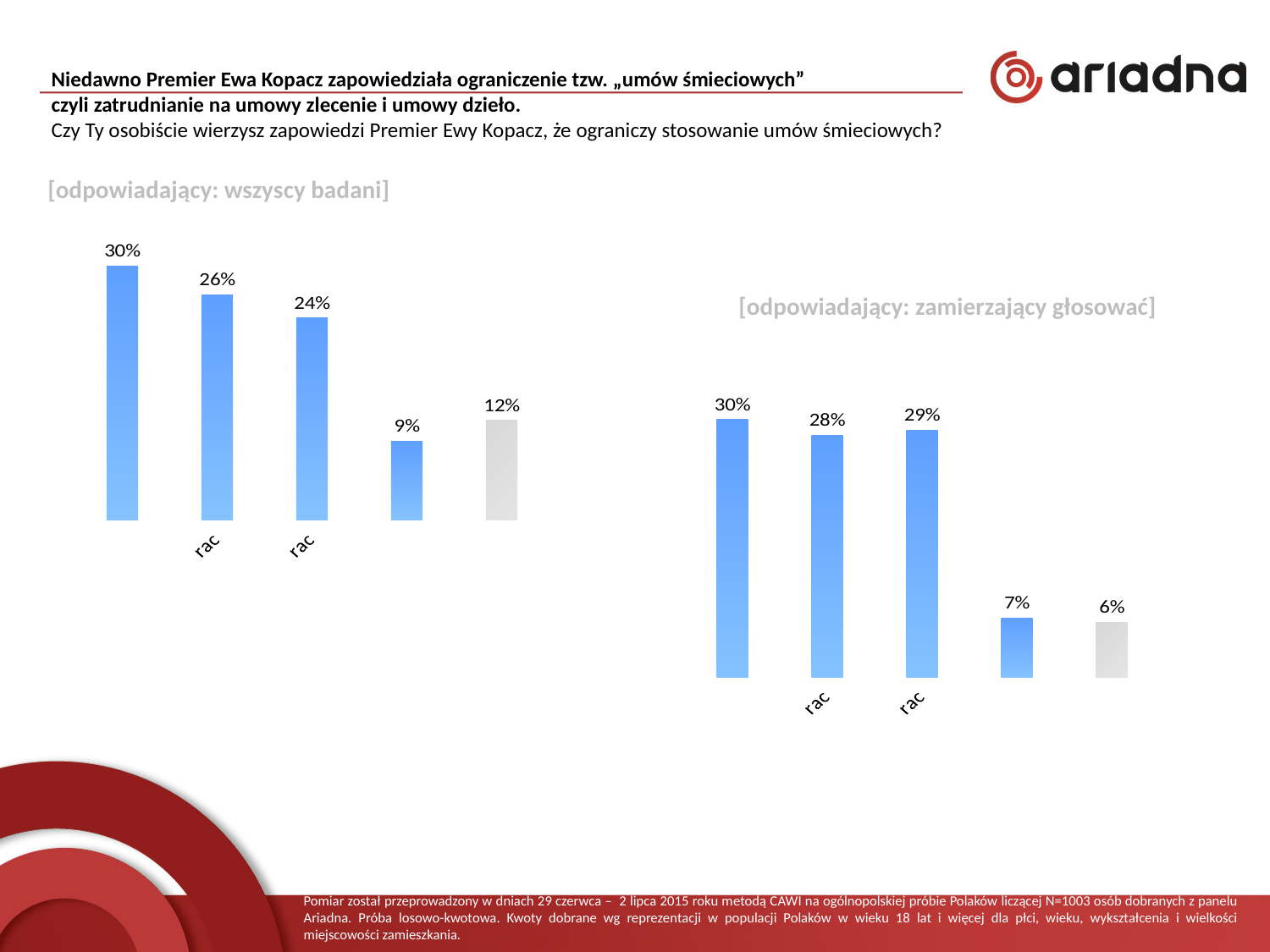
In the left chart "[odpowiadający: wszyscy badani]", how many bars are plotted? 5 In the left chart "[odpowiadający: wszyscy badani]", what is the value of the grey (rightmost) bar? 12% In the right chart "[odpowiadający: zamierzający głosować]", what is the value of the second bar from the left? 28% In the left chart "[odpowiadający: wszyscy badani]", what is the difference between the first bar (30%) and the second bar (26%)? 4% In the right chart "[odpowiadający: zamierzający głosować]", what is the difference between the third bar (29%) and the fourth bar (7%)? 22% In the right chart "[odpowiadający: zamierzający głosować]", which is larger: the fourth bar (7%) or the fifth bar (6%)? the fourth bar (7%) In the left chart "[odpowiadający: wszyscy badani]", what is the value of the first (leftmost) bar? 30% What kind of chart is the left chart titled "[odpowiadający: wszyscy badani]"? bar chart In the right chart "[odpowiadający: zamierzający głosować]", what is the value of the grey (rightmost) bar? 6% In the right chart "[odpowiadający: zamierzający głosować]", what is the highest value shown? 30% In the left chart "[odpowiadający: wszyscy badani]", what is the lowest value shown? 9% In the left chart "[odpowiadający: wszyscy badani]", what is the value of the fourth bar from the left? 9%